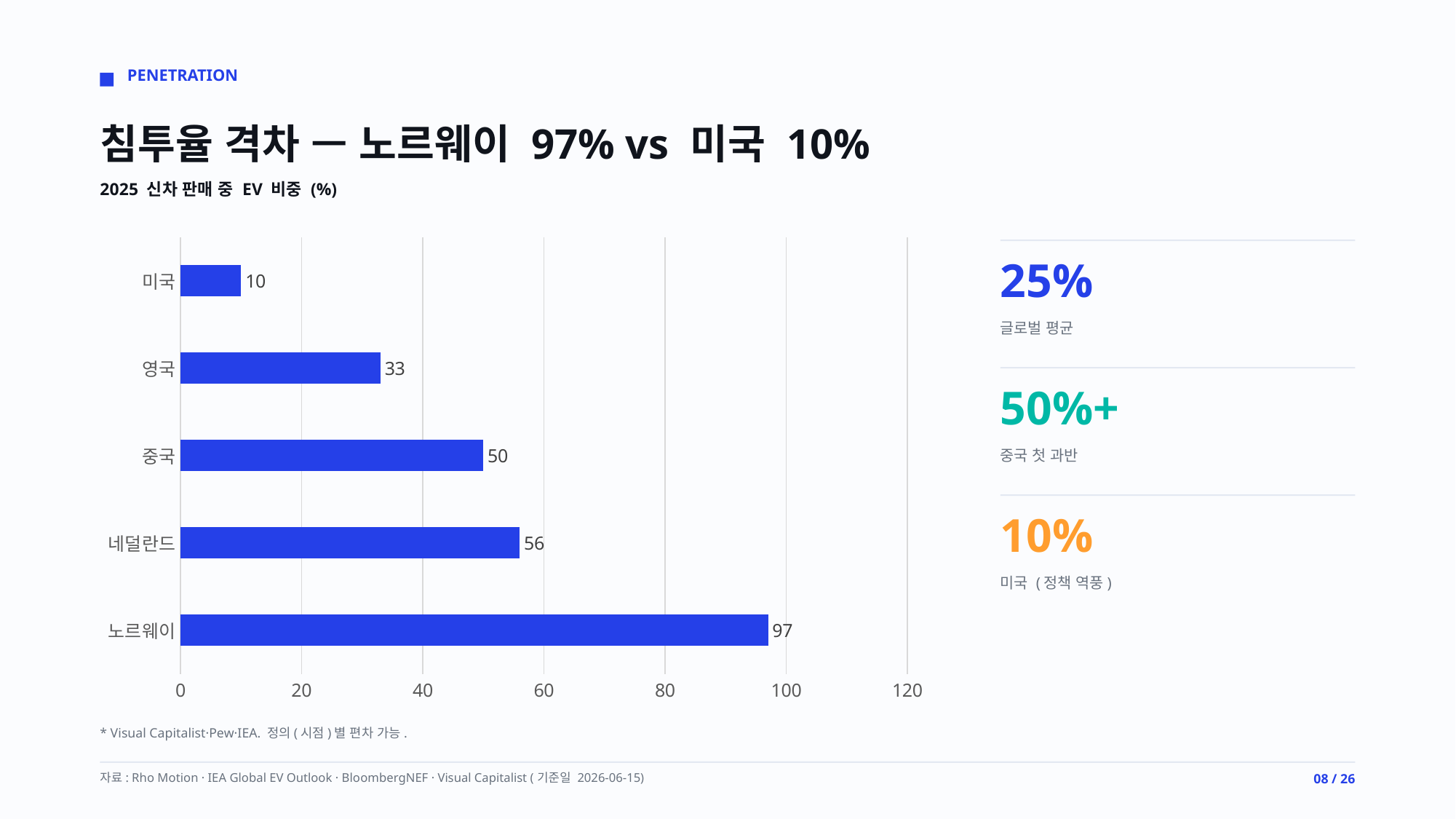
Which is larger, the value for 영국 or the value for 중국? 중국 What is the difference between the values for 노르웨이 and 미국? 87 What is the value for 네덜란드? 56 What is the value for 노르웨이? 97 What is the difference between the values for 네덜란드 and 중국? 6 What is the value for 영국? 33 Is the value for 노르웨이 greater or less than 80? greater Which category has the highest value? 노르웨이 What is the chart's subtitle describing the plotted measure? 2025 신차 판매 중 EV 비중 (%) What kind of chart is shown on the slide? bar chart Which category has the lowest value? 미국 How many categories are shown in the chart? 5